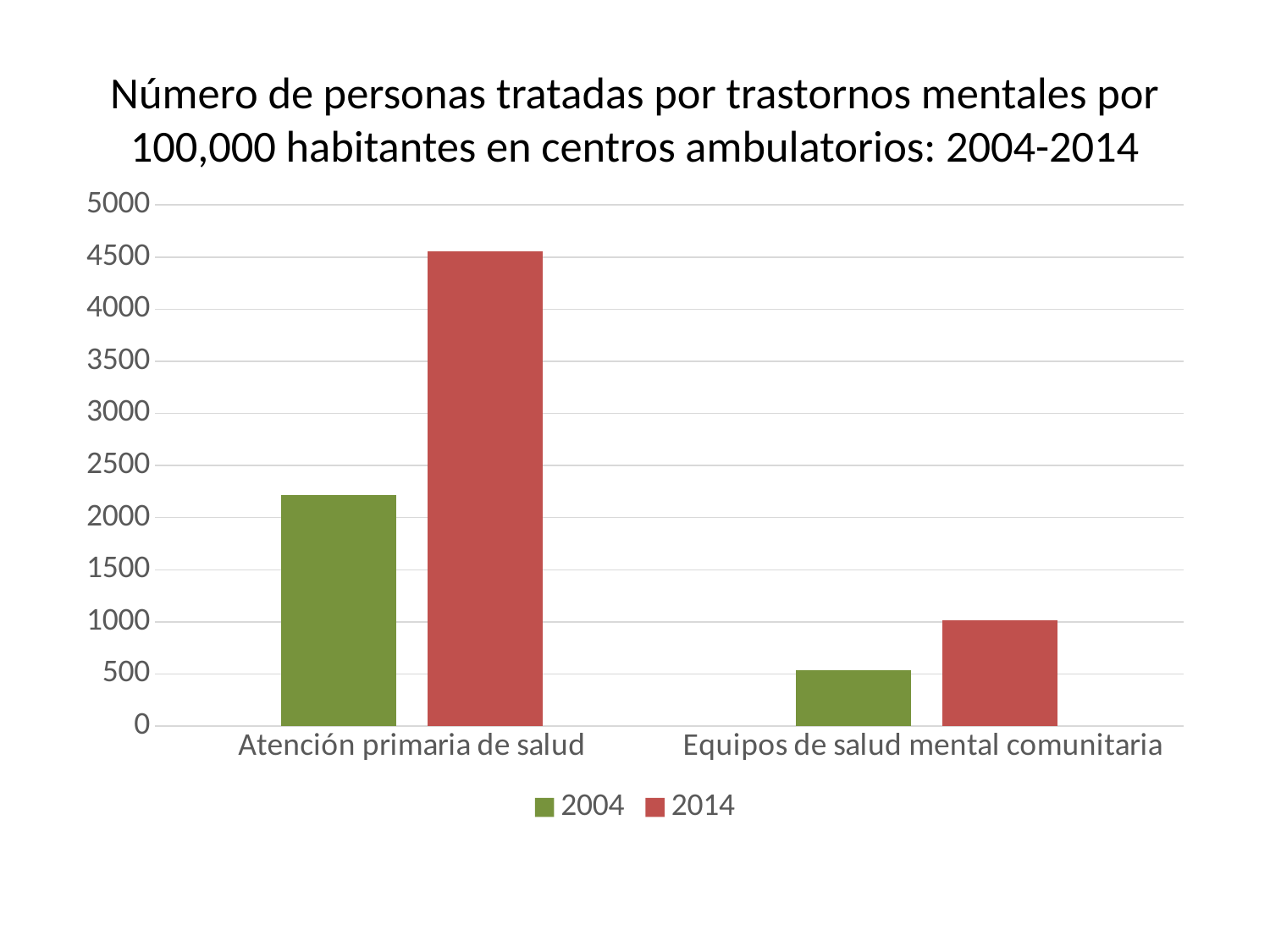
Which category has the highest 2014 value? Atención primaria de salud Is the 2014 value for Atención primaria de salud greater or less than 4000? greater For Equipos de salud mental comunitaria, which is larger, the 2004 value or the 2014 value? 2014 Which category has the lowest 2004 value? Equipos de salud mental comunitaria Which series does the legend list first? 2004 Is the 2004 value for Equipos de salud mental comunitaria greater or less than 1000? less How many series does the legend list? 2 What colour are the bars for the 2014 series? red Is the 2004 value for Atención primaria de salud greater or less than 2000? greater What kind of chart is shown on the slide? bar chart How many categories are shown on the x axis? 2